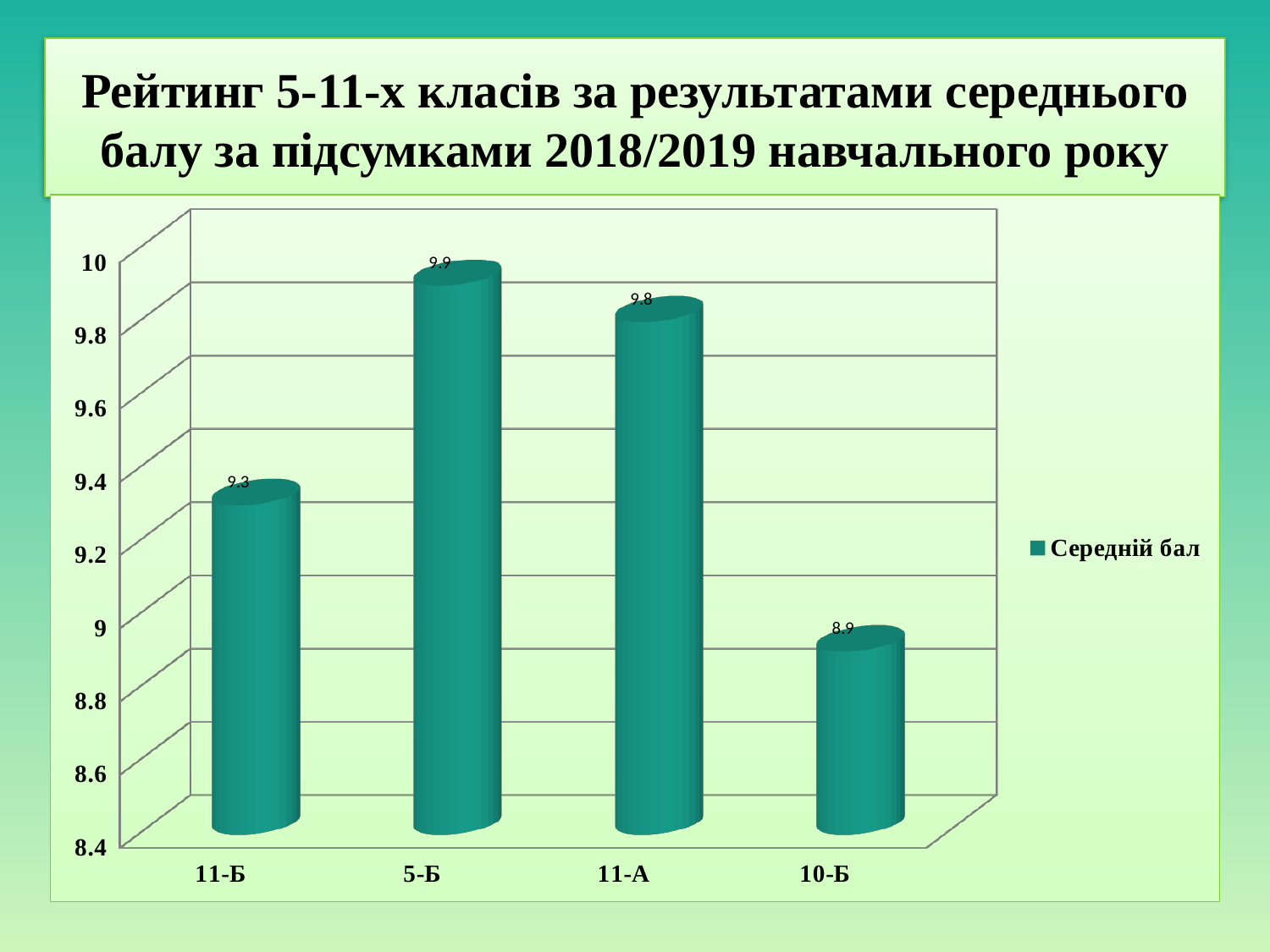
What is the value for 11-А? 9.8 Which class has the highest value? 5-Б What is the value for 5-Б? 9.9 Which class has the lowest value? 10-Б Which is larger, the value for 11-Б or the value for 10-Б? 11-Б What kind of chart is shown on the slide? bar chart What is the difference between the values for 5-Б and 10-Б? 1 What is the difference between the values for 11-А and 11-Б? 0.5 What is the value for 10-Б? 8.9 How many classes are shown on the chart? 4 What is the value for 11-Б? 9.3 How many series does the legend list? 1